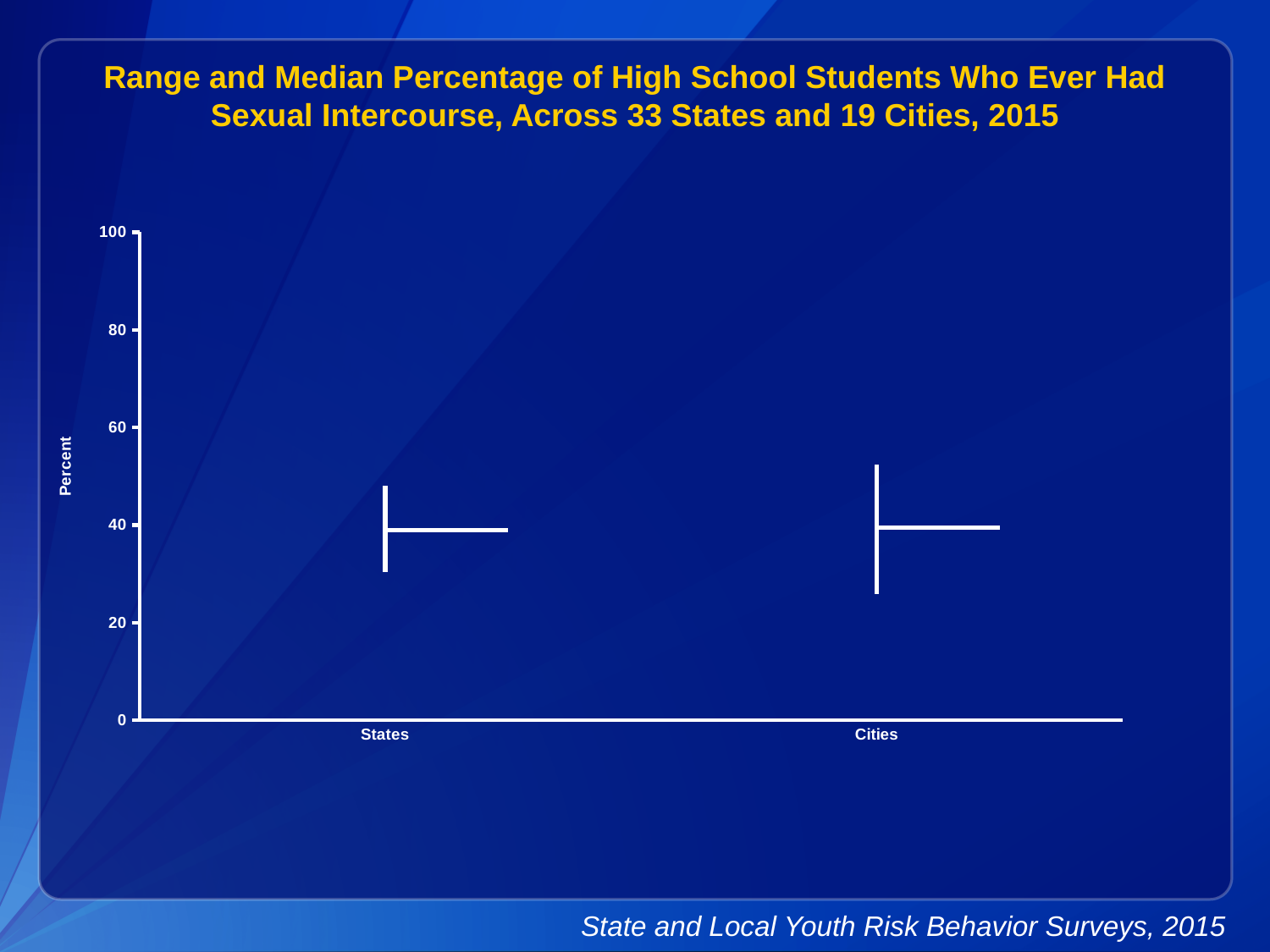
Is the top of the range for Cities greater or less than 40? greater What are the two categories shown on the x axis? States and Cities What is the label of the y axis? Percent Which category has the wider range, States or Cities? Cities Is the top of the range for States greater or less than 40? greater Is the bottom of the range for Cities greater or less than 20? greater How many categories are shown on the x axis of the chart? 2 Which category has the lower bottom of its range, States or Cities? Cities Which category has the higher top of its range, States or Cities? Cities What is the highest value shown on the y axis? 100